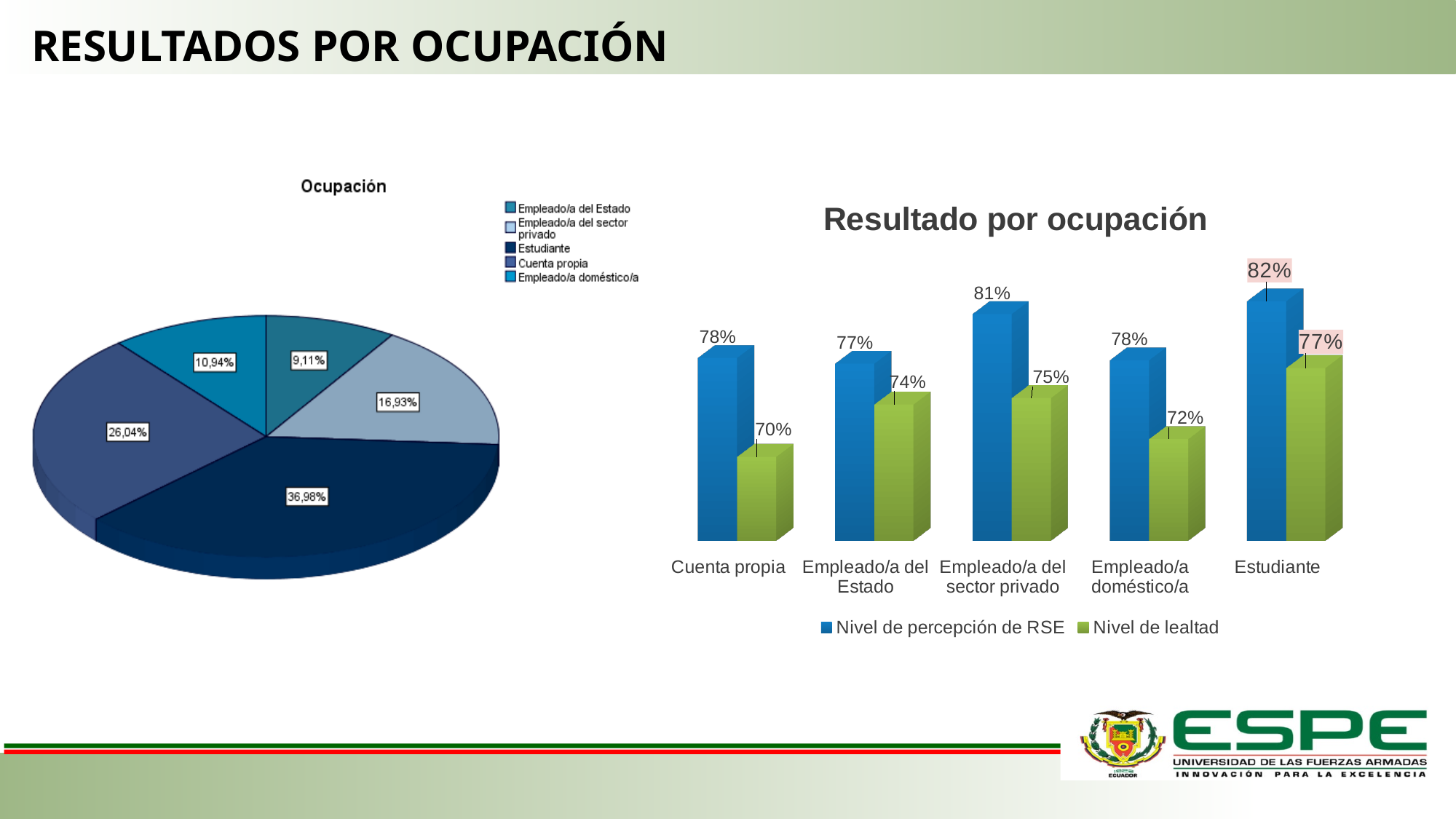
How many series does the legend of the 'Resultado por ocupación' chart list? 2 How many occupation categories are shown in the 'Resultado por ocupación' chart? 5 In the 'Resultado por ocupación' chart, is the Nivel de lealtad higher for Empleado/a del Estado or for Empleado/a doméstico/a? Empleado/a del Estado In the 'Ocupación' pie chart, what share does the Estudiante slice have? 36,98% In the 'Resultado por ocupación' chart, what is the Nivel de lealtad for Cuenta propia? 70% In the 'Resultado por ocupación' chart, which occupation has the highest Nivel de percepción de RSE? Estudiante In the 'Resultado por ocupación' chart, which occupation has the lowest Nivel de lealtad? Cuenta propia In the 'Ocupación' pie chart, which occupation has the smallest slice? Empleado/a del Estado In the 'Resultado por ocupación' chart, what is the Nivel de percepción de RSE for Estudiante? 82% What kind of chart is the 'Ocupación' chart on the left? Pie chart What kind of chart is the 'Resultado por ocupación' chart on the right? Bar chart In the 'Resultado por ocupación' chart, what is the difference between Nivel de percepción de RSE and Nivel de lealtad for Empleado/a del sector privado? 6%